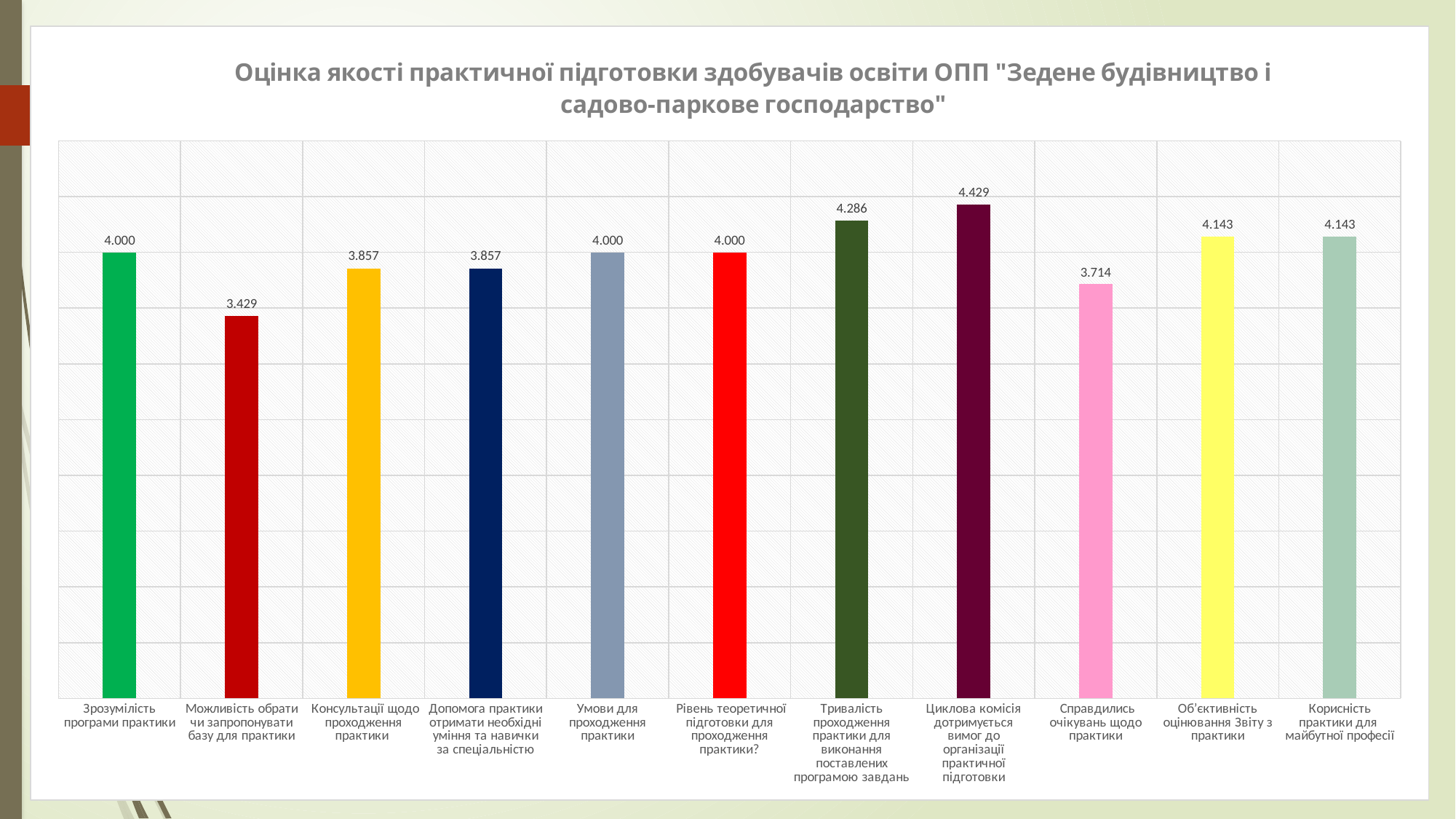
What colour is the bar for "Справдились очікувань щодо практики"? Pink What is the difference between the highest value (4.429) and the lowest value (3.429)? 1.000 Which is larger: the value for "Тривалість проходження практики для виконання поставлених програмою завдань" or for "Об'єктивність оцінювання Звіту з практики"? Тривалість проходження практики для виконання поставлених програмою завдань What is the value for "Тривалість проходження практики для виконання поставлених програмою завдань"? 4.286 Which category has the highest value? Циклова комісія дотримується вимог до організації практичної підготовки What is the value for "Справдились очікувань щодо практики"? 3.714 What is the value for "Зрозумілість програми практики"? 4.000 How many categories (bars) are shown in the chart? 11 What is the difference between the values for "Тривалість проходження практики для виконання поставлених програмою завдань" and "Справдились очікувань щодо практики"? 0.572 Which category has the lowest value? Можливість обрати чи запропонувати базу для практики What is the value for "Консультації щодо проходження практики"? 3.857 What kind of chart is shown on the slide? Bar chart